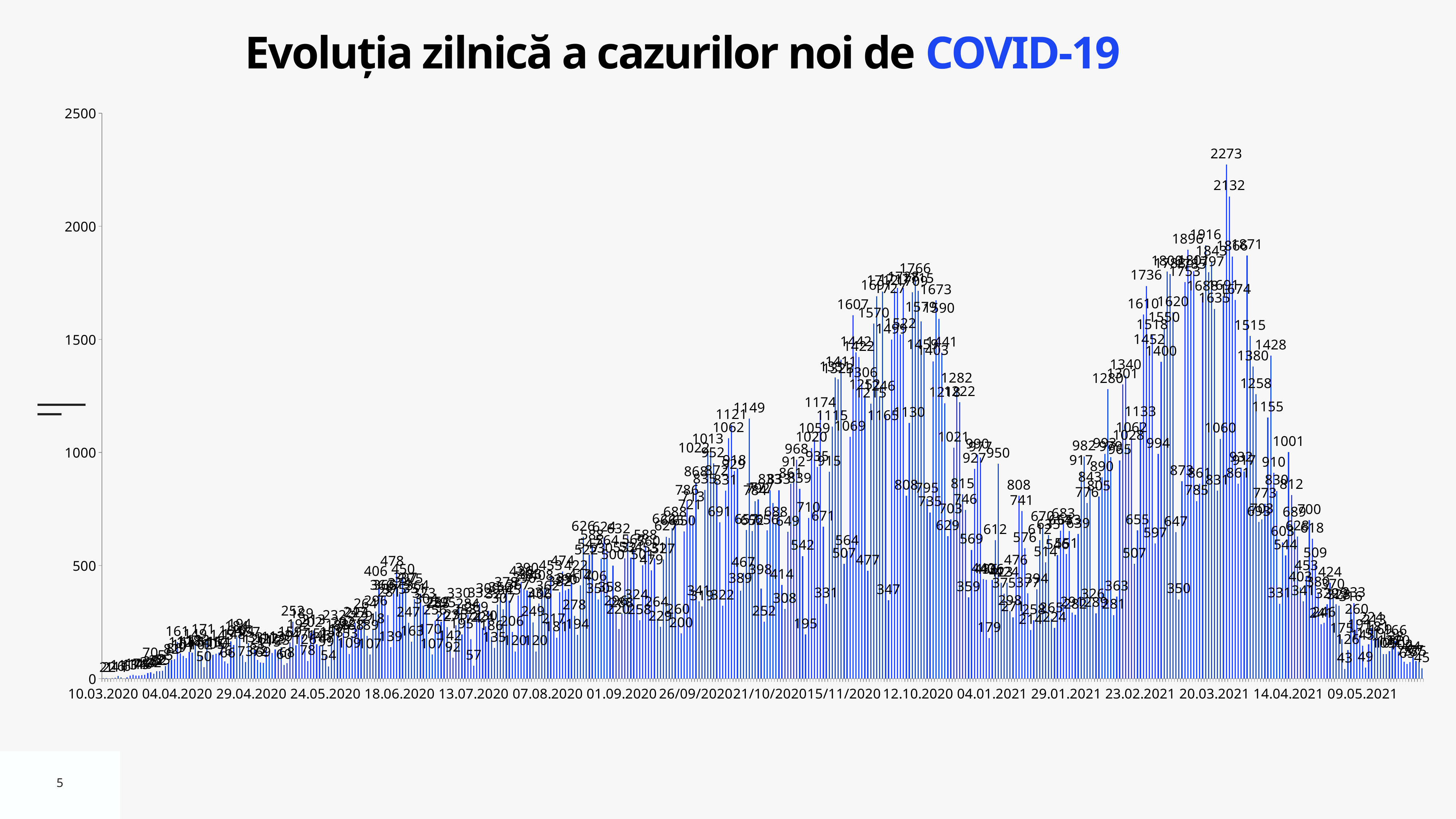
What is the maximum value shown on the vertical axis? 2500 Do the values rise or fall between 14.04.2021 and 09.05.2021? fall Are the values at the very start of the chart (around 10.03.2020) greater or less than 500? less Is the highest value on the chart greater or less than 2000? greater Do the values rise or fall between 10.03.2020 and 04.04.2020? rise What is the highest daily value labelled on the chart? 2273 What is the second-highest daily value labelled on the chart, next to the 2273 peak? 2132 What kind of chart is shown on the slide? bar chart What is the title of the chart? Evoluția zilnică a cazurilor noi de COVID-19 Which peak is higher: the one around 12.10.2020 or the one around 20.03.2021? the one around 20.03.2021 Is the highest value on the chart greater or less than 2500? less What is the difference between the two highest labelled values, 2273 and 2132? 141